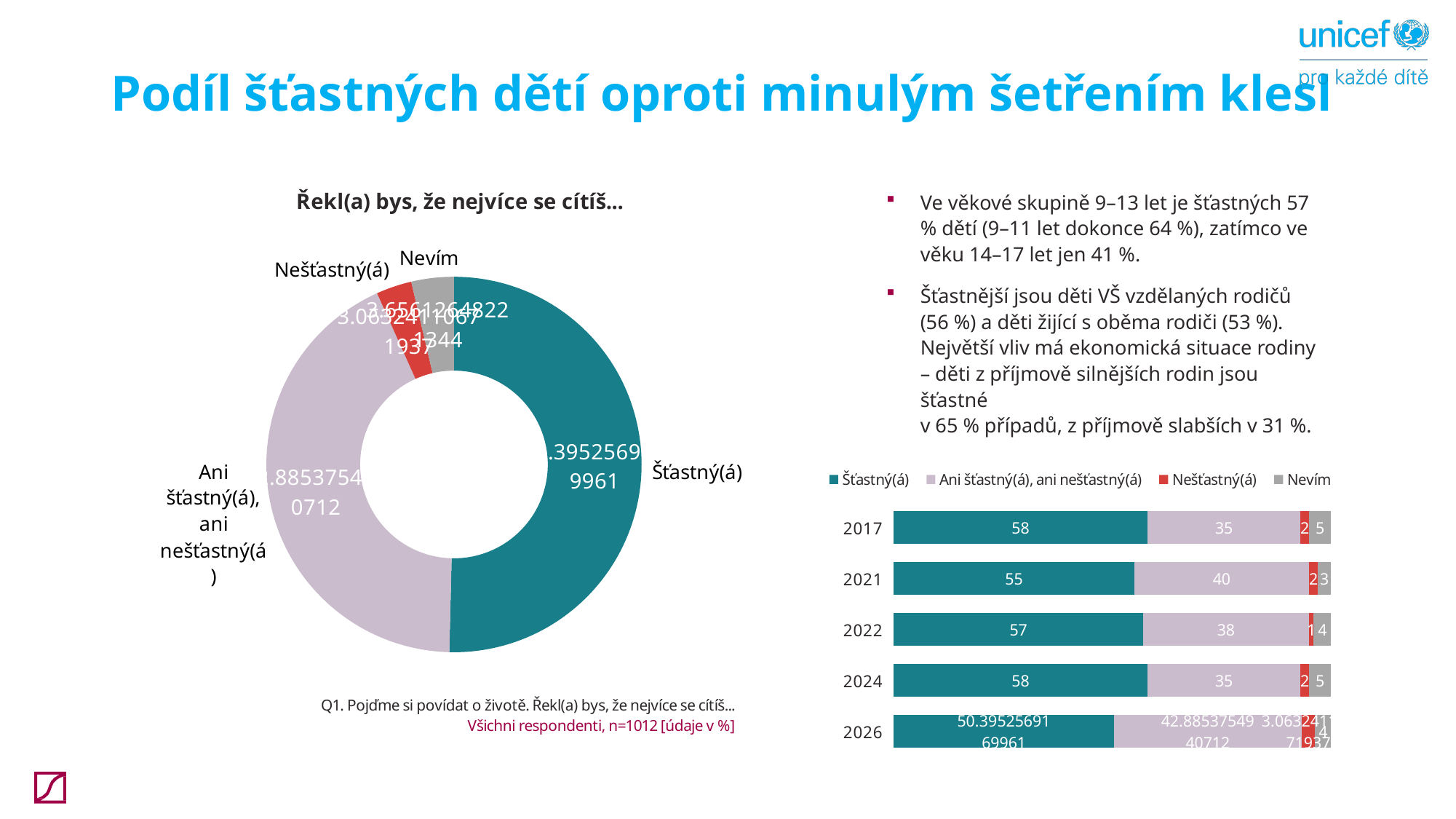
In the bar chart on the right, what is the value for Šťastný(á) in 2021? 55 In the bar chart on the right, how many years are shown? 5 What is the title of the pie chart on the left? Řekl(a) bys, že nejvíce se cítíš… What kind of chart is the chart on the left of the slide? doughnut chart In the bar chart on the right, what is the value for Nevím in 2017? 5 In the bar chart on the right, what is the value for Ani šťastný(á), ani nešťastný(á) in 2022? 38 In the bar chart on the right, what is the difference between the Šťastný(á) values for 2017 and 2021? 3 In the bar chart on the right, how many series does the legend list? 4 In the bar chart on the right, what is the value for Nešťastný(á) in 2022? 1 In the pie chart on the left, which category has the largest slice? Šťastný(á) In the bar chart on the right, which year has the larger value for Ani šťastný(á), ani nešťastný(á): 2021 or 2024? 2021 What kind of chart is the chart on the right of the slide showing the years 2017 to 2026? bar chart